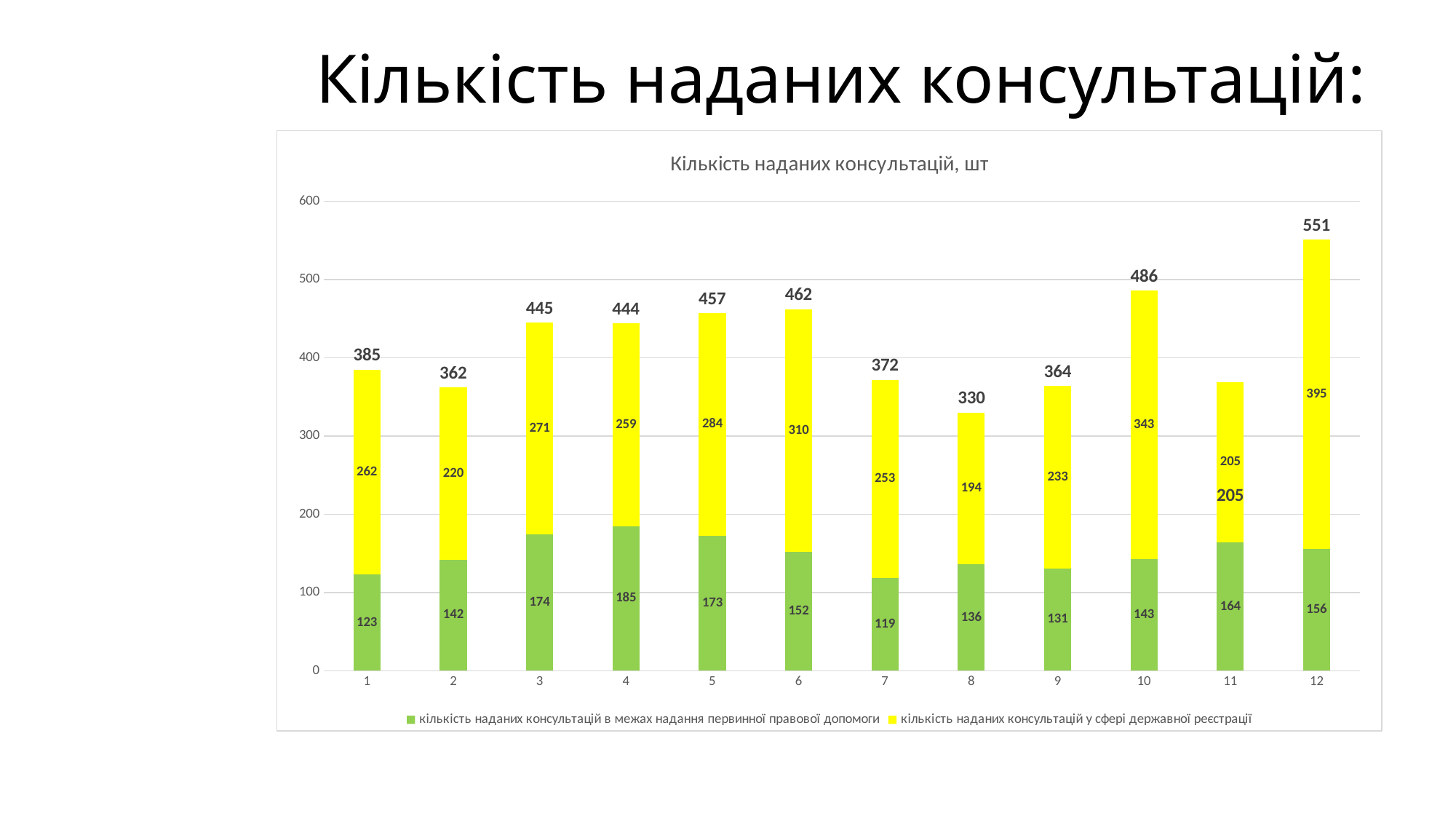
What is the title shown inside the chart area? Кількість наданих консультацій, шт Which category has the lowest stacked bar total? 8 Which is larger: the green series value for category 3 or for category 9? category 3 Which category has the highest stacked bar total? 12 What kind of chart is shown on the slide? stacked bar chart What is the value of the yellow series (консультацій у сфері державної реєстрації) for category 12? 395 Is the stacked bar total for category 6 greater or less than 400? greater What is the total of the stacked bar for category 10? 486 How many categories are shown on the x axis of the chart? 12 How many series does the legend list? 2 What is the difference between the yellow series values for category 12 and category 1? 133 What is the value of the green series (консультацій в межах надання первинної правової допомоги) for category 4? 185